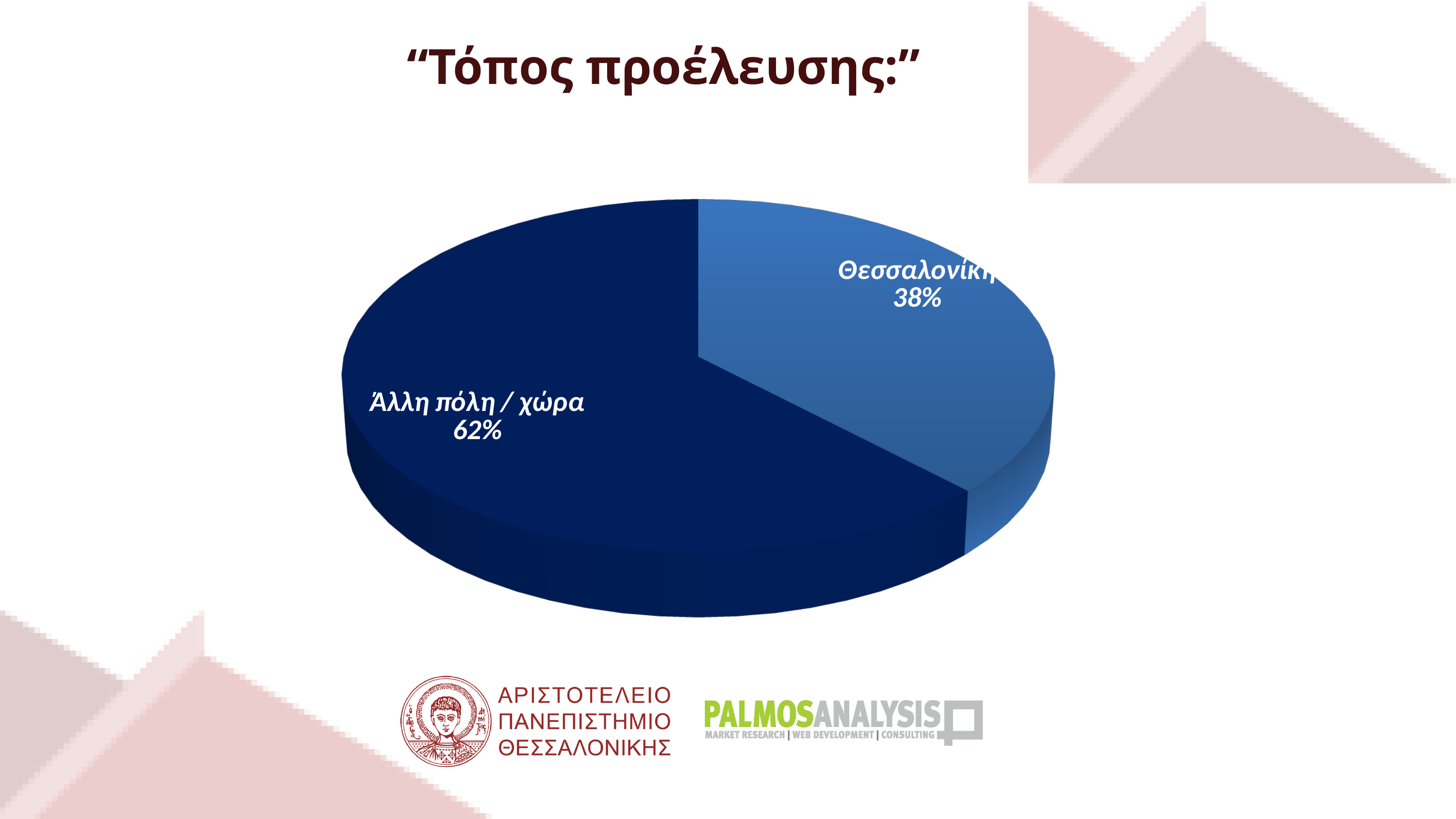
What is the difference between the shares of Άλλη πόλη / χώρα and Θεσσαλονίκη? 24% What is the title of the chart? "Τόπος προέλευσης:" Which slice is shown in the lighter blue colour? Θεσσαλονίκη Which category has the smallest share of the pie? Θεσσαλονίκη What kind of chart is shown on the slide? pie chart What is the value for Θεσσαλονίκη? 38% What is the value for Άλλη πόλη / χώρα? 62% What share of the pie does Θεσσαλονίκη represent? 38% How many slices does the pie chart have? 2 Which category has the largest share of the pie? Άλλη πόλη / χώρα Which is larger, the share for Θεσσαλονίκη or the share for Άλλη πόλη / χώρα? Άλλη πόλη / χώρα